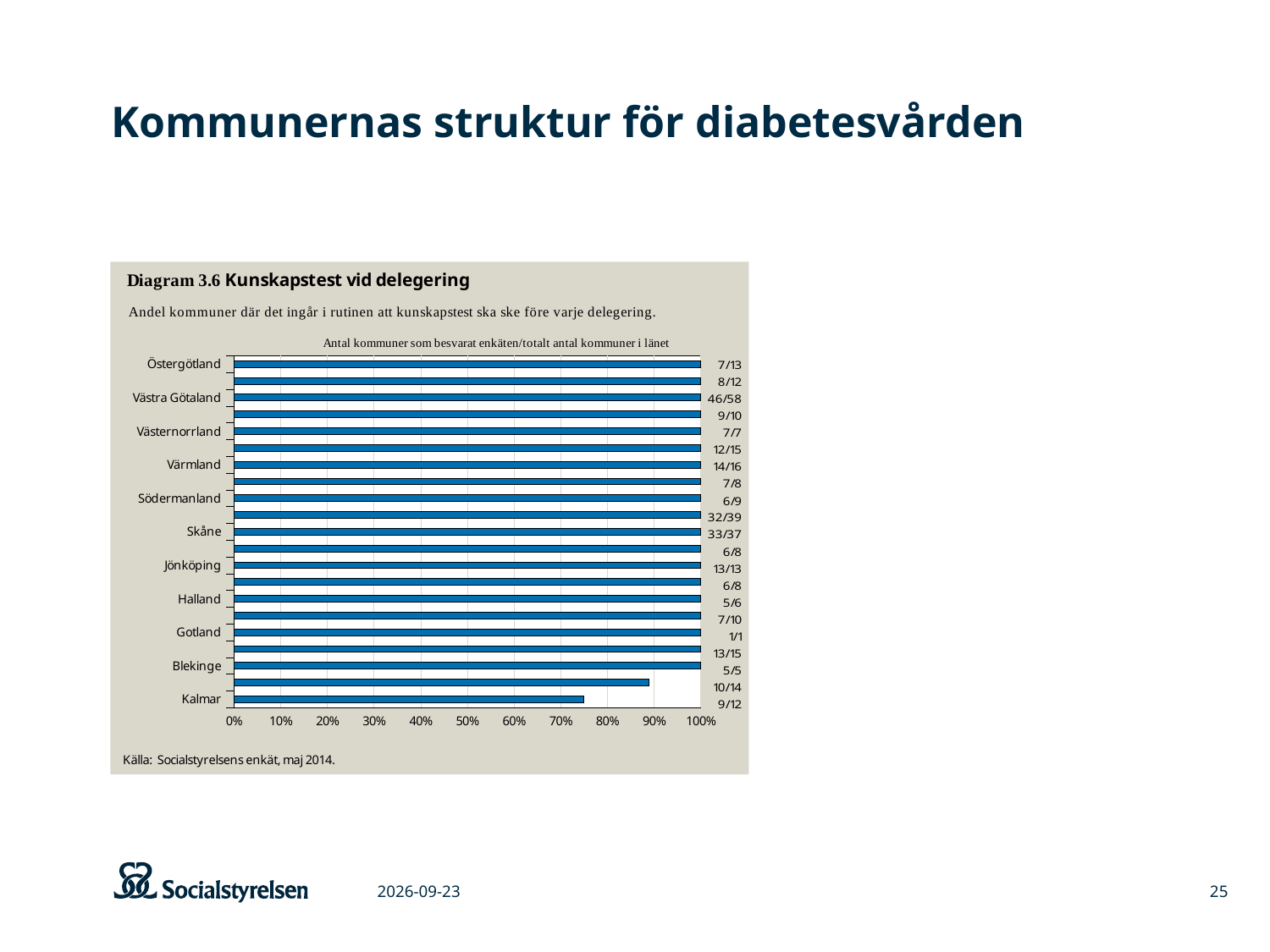
What is the title of the diagram on the slide? Diagram 3.6 Kunskapstest vid delegering Is the value for Kalmar greater or less than 70%? greater What kind of chart is Diagram 3.6 on the slide? bar chart Which has the larger share, Blekinge or Kalmar? Blekinge Which county has the lowest share in the chart? Kalmar How many bars are plotted in the chart? 21 What is the number of responding municipalities out of the total shown next to the bar for Västra Götaland? 46/58 Is the value for Kalmar greater or less than 80%? less What source is given below the chart? Socialstyrelsens enkät, maj 2014 What is the number of responding municipalities out of the total shown next to the bar for Kalmar? 9/12 What is the number of responding municipalities out of the total shown next to the bar for Skåne? 33/37 Is the value for Blekinge greater or less than 90%? greater